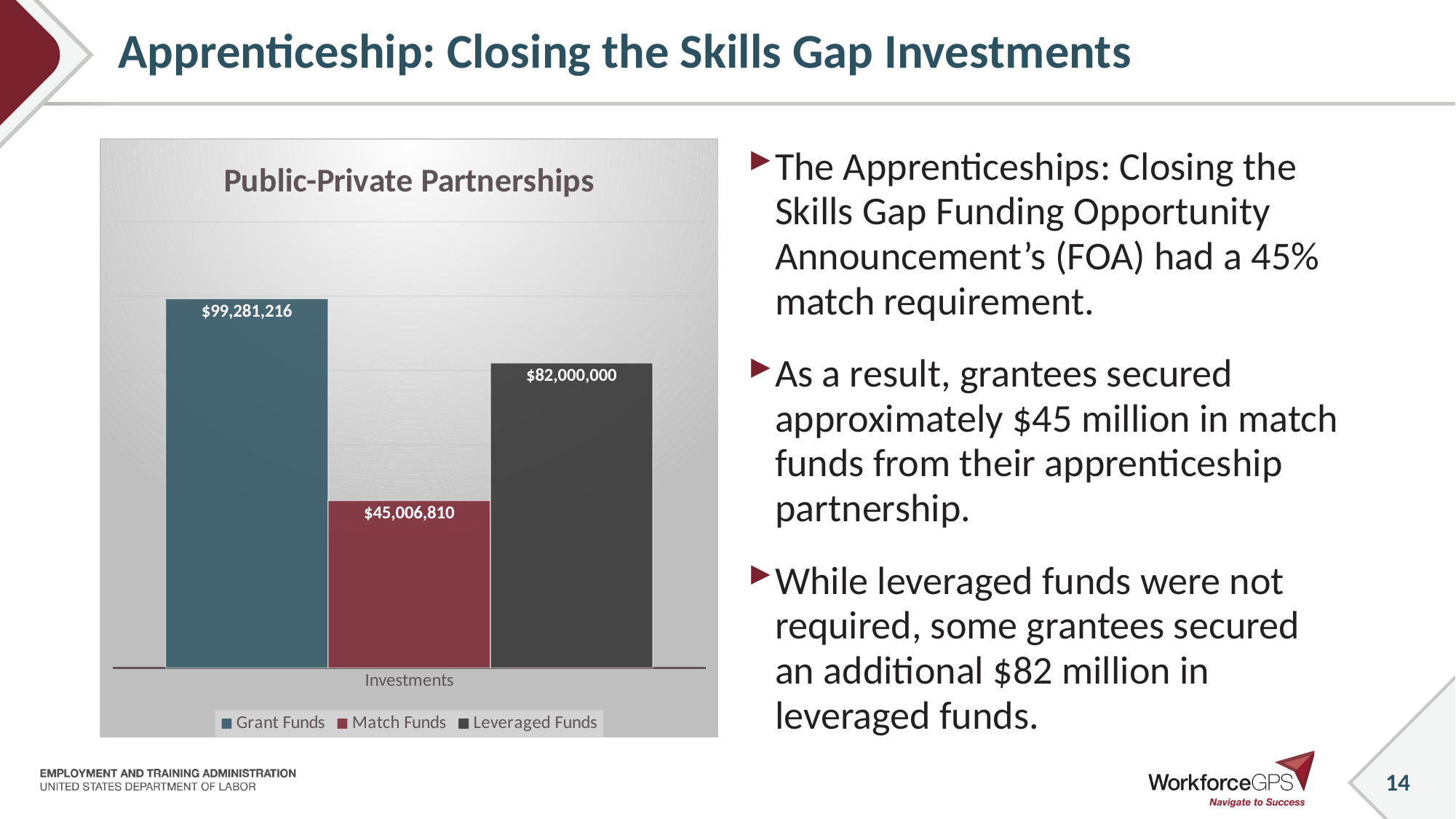
Which series has the lowest value in the Public-Private Partnerships chart? Match Funds What kind of chart is the Public-Private Partnerships chart? Bar chart What is the value for Leveraged Funds in the Public-Private Partnerships chart? $82,000,000 Which series has the highest value in the Public-Private Partnerships chart? Grant Funds How many series does the legend of the Public-Private Partnerships chart list? 3 What is the value for Grant Funds in the Public-Private Partnerships chart? $99,281,216 What is the difference between Grant Funds and Match Funds in the Public-Private Partnerships chart? $54,274,406 Which is larger in the Public-Private Partnerships chart, Leveraged Funds or Match Funds? Leveraged Funds What is the value for Match Funds in the Public-Private Partnerships chart? $45,006,810 What is the difference between Leveraged Funds and Match Funds in the Public-Private Partnerships chart? $36,993,190 What is the category label on the x axis of the Public-Private Partnerships chart? Investments What is the difference between Grant Funds and Leveraged Funds in the Public-Private Partnerships chart? $17,281,216